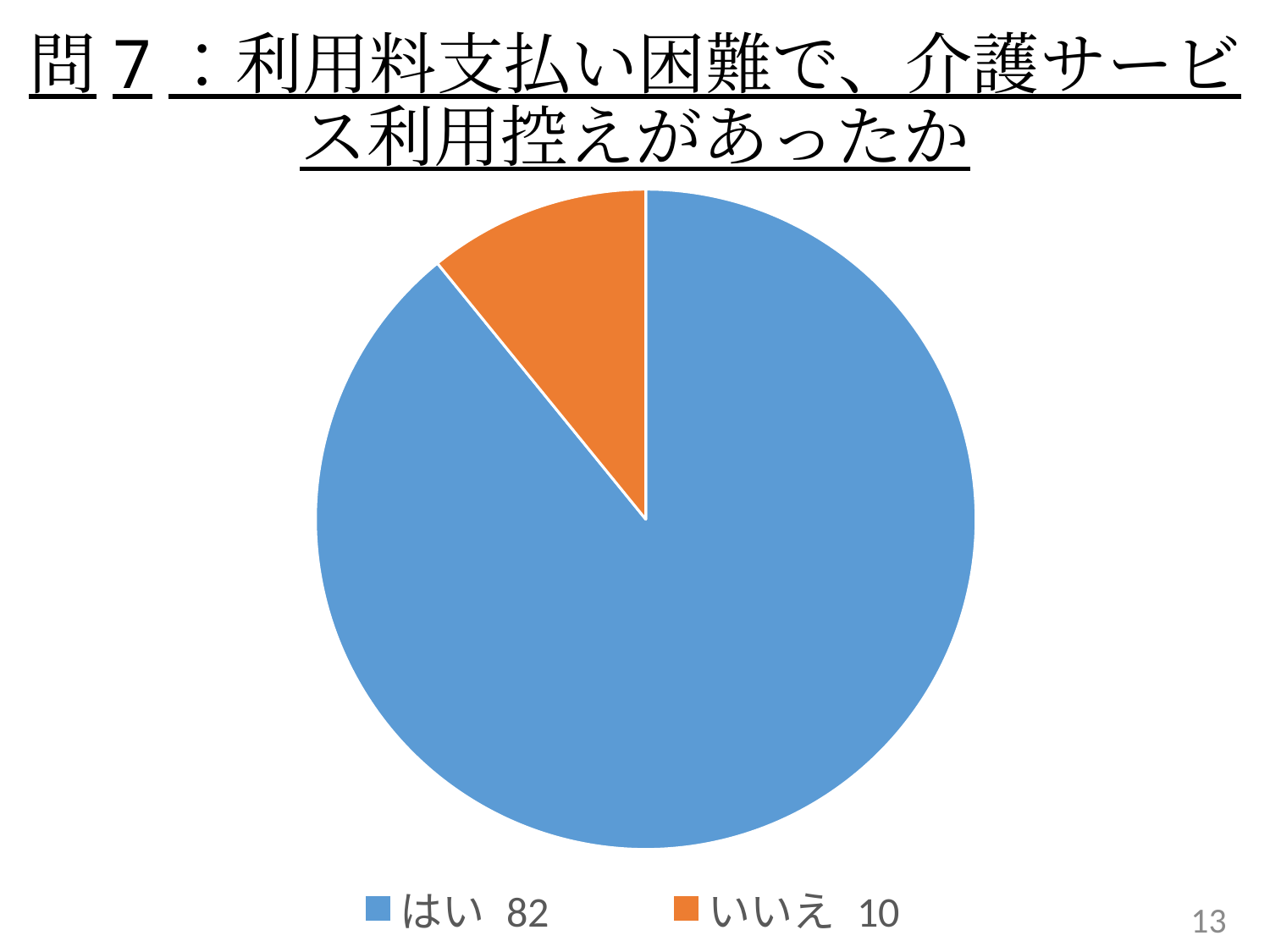
What kind of chart is shown on the slide? pie chart How many categories does the pie chart have? 2 What is the value for いいえ? 10 How many entries does the legend list? 2 What is the difference between the values for はい and いいえ? 72 What is the value for はい? 82 Which is larger, the value for はい or the value for いいえ? はい Which category has the smallest slice of the pie? いいえ What is the total of the two values shown in the legend? 92 What colour is the slice for はい? blue Which category has the largest slice of the pie? はい What colour is the slice for いいえ? orange